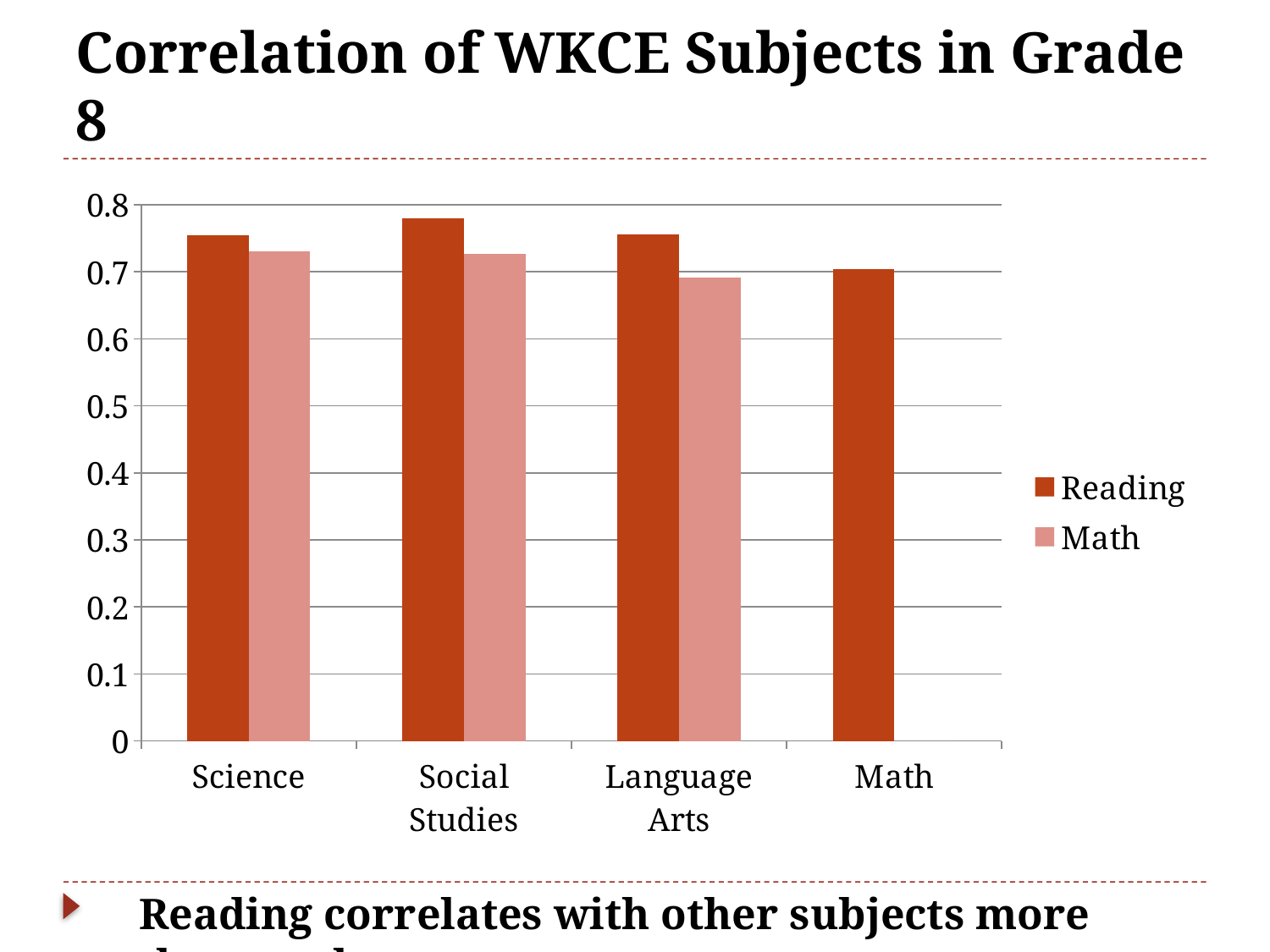
Is the Reading value for Social Studies greater or less than 0.7? greater Is the Math value for Science greater or less than 0.7? greater Which category has the highest Reading value? Social Studies For Social Studies, which is larger, the Reading value or the Math value? Reading Is the Reading value for Science greater or less than 0.8? less What kind of chart is shown on the slide? bar chart Which category has the lowest Reading value? Math Which category has no Math bar plotted? Math How many series does the legend list? 2 How many subject categories are shown on the x axis? 4 For Language Arts, which is larger, the Reading value or the Math value? Reading